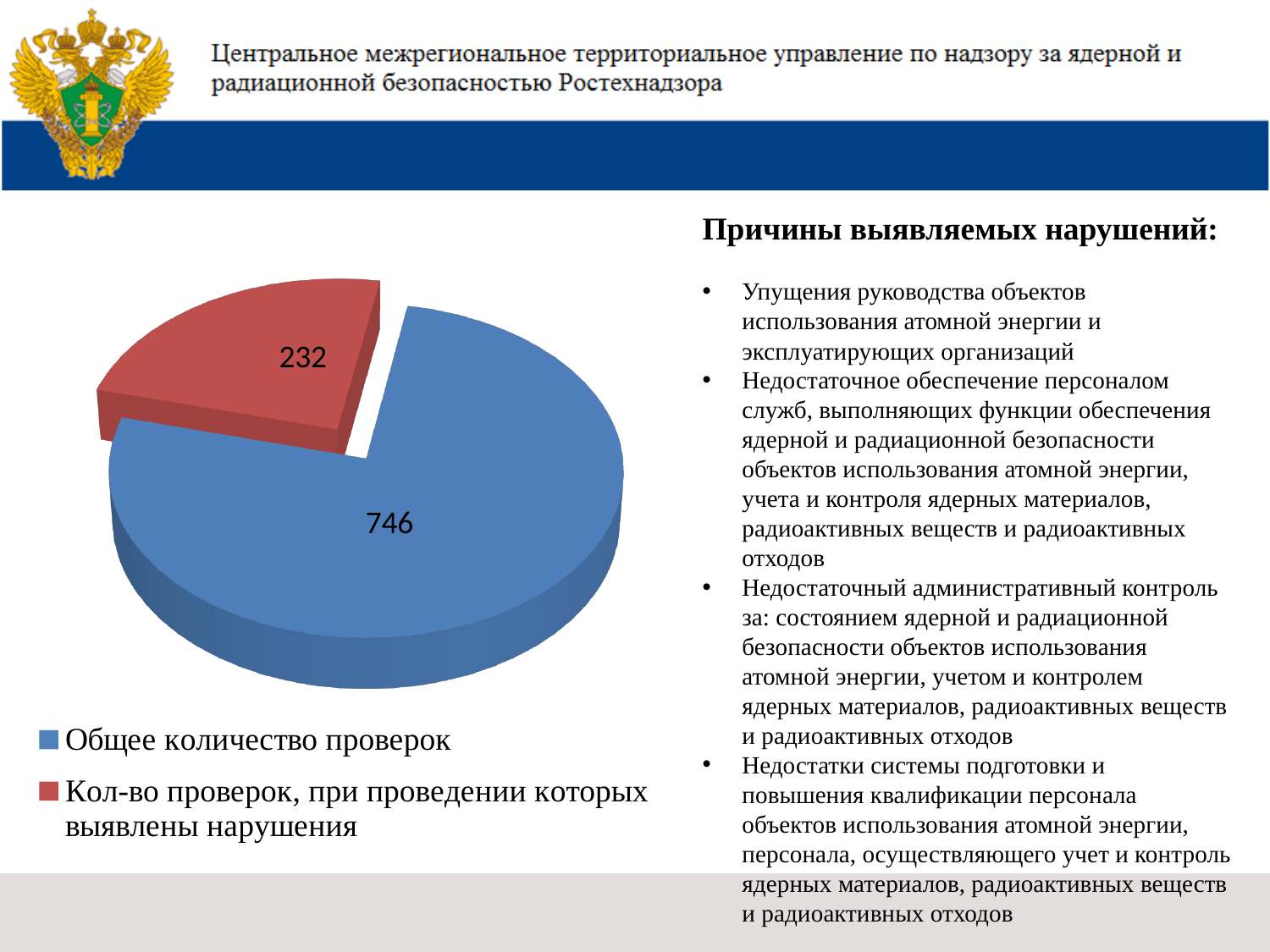
Which slice of the pie chart is the smallest? Кол-во проверок, при проведении которых выявлены нарушения What value is shown for the slice labelled "Общее количество проверок"? 746 What kind of chart is shown on the slide? Pie chart What is the difference between the two values shown on the pie chart? 514 What is the sum of the two values shown on the pie chart? 978 What value is shown for the slice "Кол-во проверок, при проведении которых выявлены нарушения"? 232 To the nearest whole percent, what share of the pie does the slice with value 232 represent? 24% How many entries does the chart legend list? 2 Which slice of the pie chart is the largest? Общее количество проверок How many slices does the pie chart have? 2 What colour is the slice for "Кол-во проверок, при проведении которых выявлены нарушения"? Red Which is larger: the value for "Общее количество проверок" or the value for "Кол-во проверок, при проведении которых выявлены нарушения"? Общее количество проверок